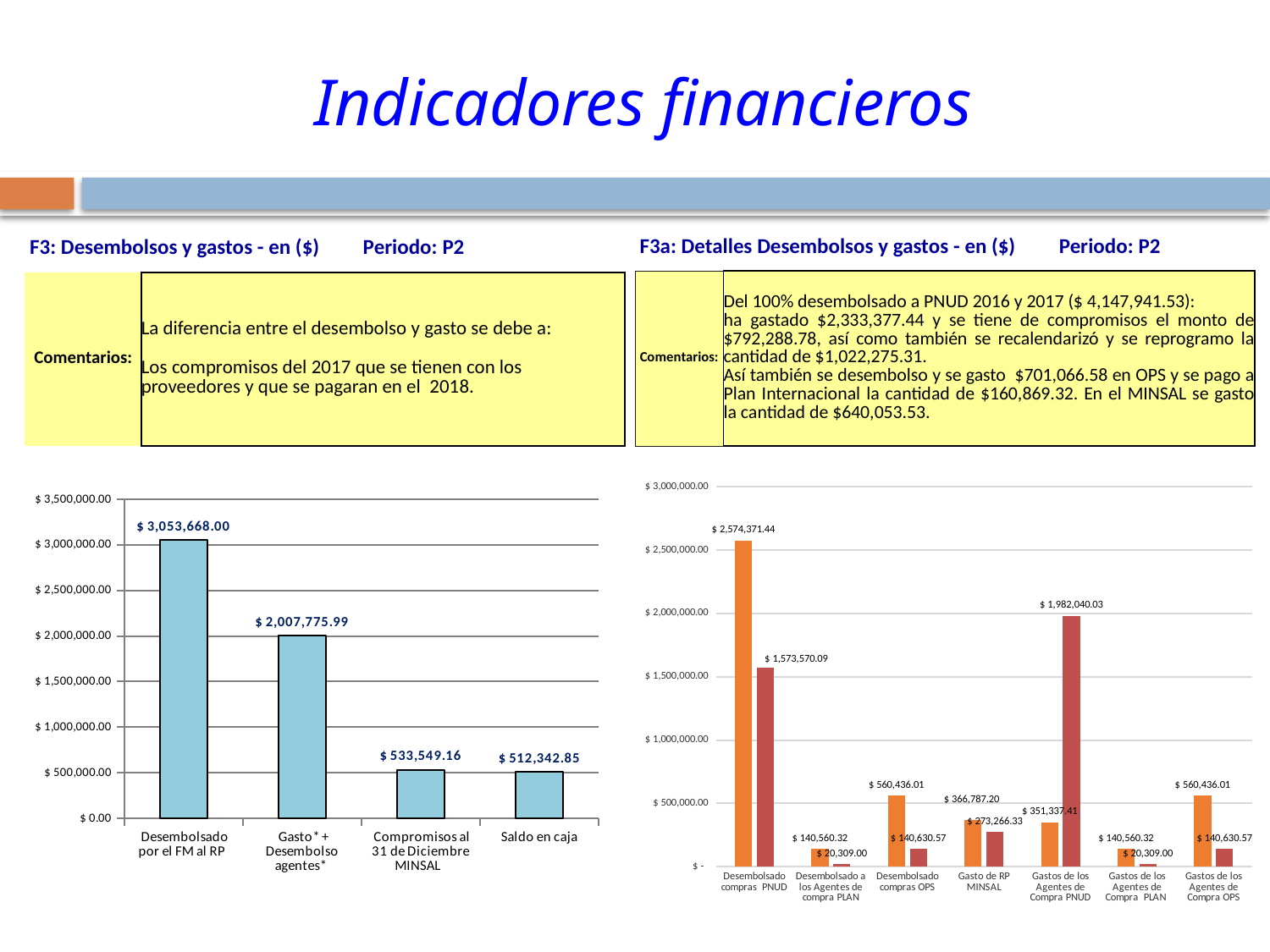
In the right chart (F3a: Detalles Desembolsos y gastos), which is larger for 'Gasto de RP MINSAL': the orange bar or the red bar? The orange bar In the right chart (F3a: Detalles Desembolsos y gastos), what is the value of the orange bar for 'Desembolsado compras PNUD'? $ 2,574,371.44 In the left chart (F3: Desembolsos y gastos), do the values rise or fall from left to right? Fall In the right chart (F3a: Detalles Desembolsos y gastos), what is the value of the red bar for 'Gastos de los Agentes de Compra PNUD'? $ 1,982,040.03 In the left chart (F3: Desembolsos y gastos), what is the value for 'Desembolsado por el FM al RP'? $ 3,053,668.00 In the left chart (F3: Desembolsos y gastos), which category has the highest value? Desembolsado por el FM al RP In the right chart (F3a: Detalles Desembolsos y gastos), how many categories are shown on the x axis? 7 In the left chart (F3: Desembolsos y gastos), what is the value for 'Saldo en caja'? $ 512,342.85 In the left chart (F3: Desembolsos y gastos), how many bars are plotted? 4 What type of chart is the left chart (F3: Desembolsos y gastos)? Bar chart In the left chart (F3: Desembolsos y gastos), which category has the lowest value? Saldo en caja In the left chart (F3: Desembolsos y gastos), what is the difference between 'Desembolsado por el FM al RP' and 'Gasto* + Desembolso agentes*'? $ 1,045,892.01